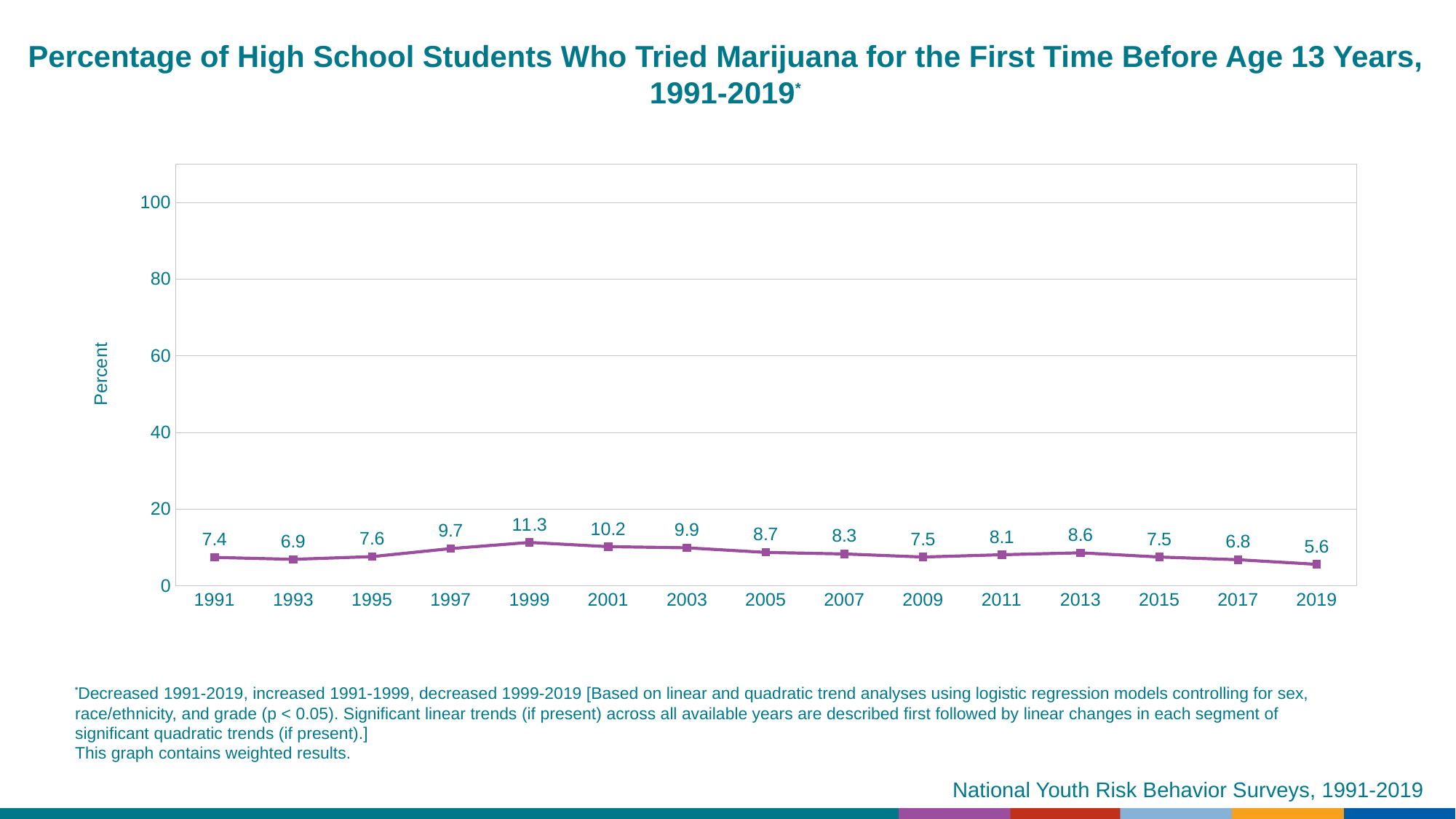
Which is larger, the value for 2001 or the value for 2013? 2001 What is the value for 1991? 7.4 What is the label on the y axis? Percent Which year has the lowest value? 2019 What is the difference between the values for 1999 and 2019? 5.7 Is the value for 1999 greater or less than 20? less How many years are plotted on the x axis? 15 What kind of chart is shown? line chart What is the value for 2019? 5.6 What is the value for 1999? 11.3 Do the values rise or fall from 1999 to 2019? fall Which year has the highest value? 1999